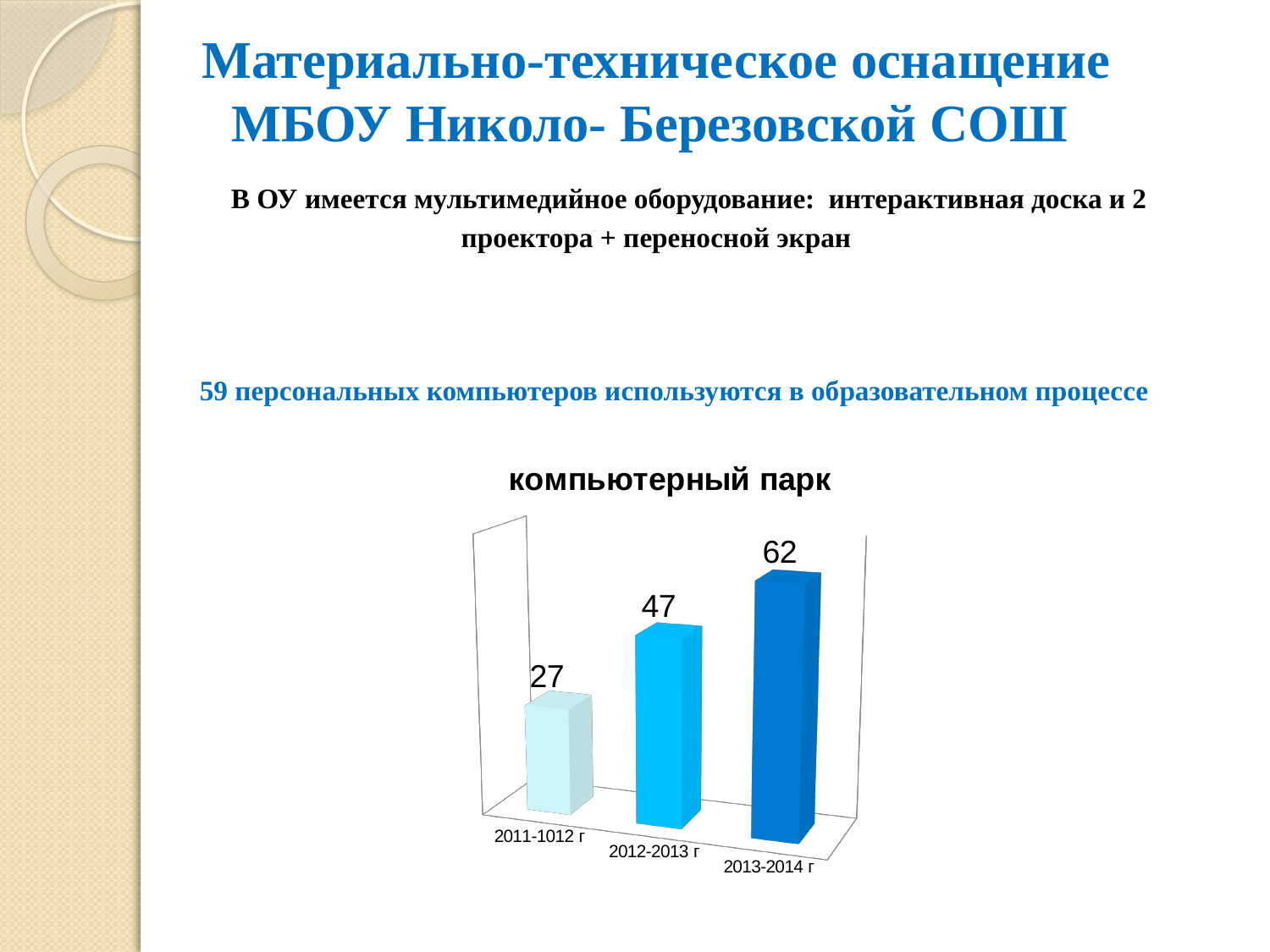
What is the value for 2012-2013 г in the компьютерный парк chart? 47 What is the value for 2011-1012 г in the компьютерный парк chart? 27 Which category has the lowest value in the компьютерный парк chart? 2011-1012 г What is the value for 2013-2014 г in the компьютерный парк chart? 62 What kind of chart is shown on the slide? bar chart What is the difference between the values for 2013-2014 г and 2011-1012 г? 35 Which category has the highest value in the компьютерный парк chart? 2013-2014 г What is the title of the chart on the slide? компьютерный парк What is the difference between the values for 2012-2013 г and 2011-1012 г? 20 Which is larger: the value for 2012-2013 г or the value for 2013-2014 г? 2013-2014 г Do the values rise or fall from 2011-1012 г to 2013-2014 г? rise How many categories are shown in the компьютерный парк chart? 3